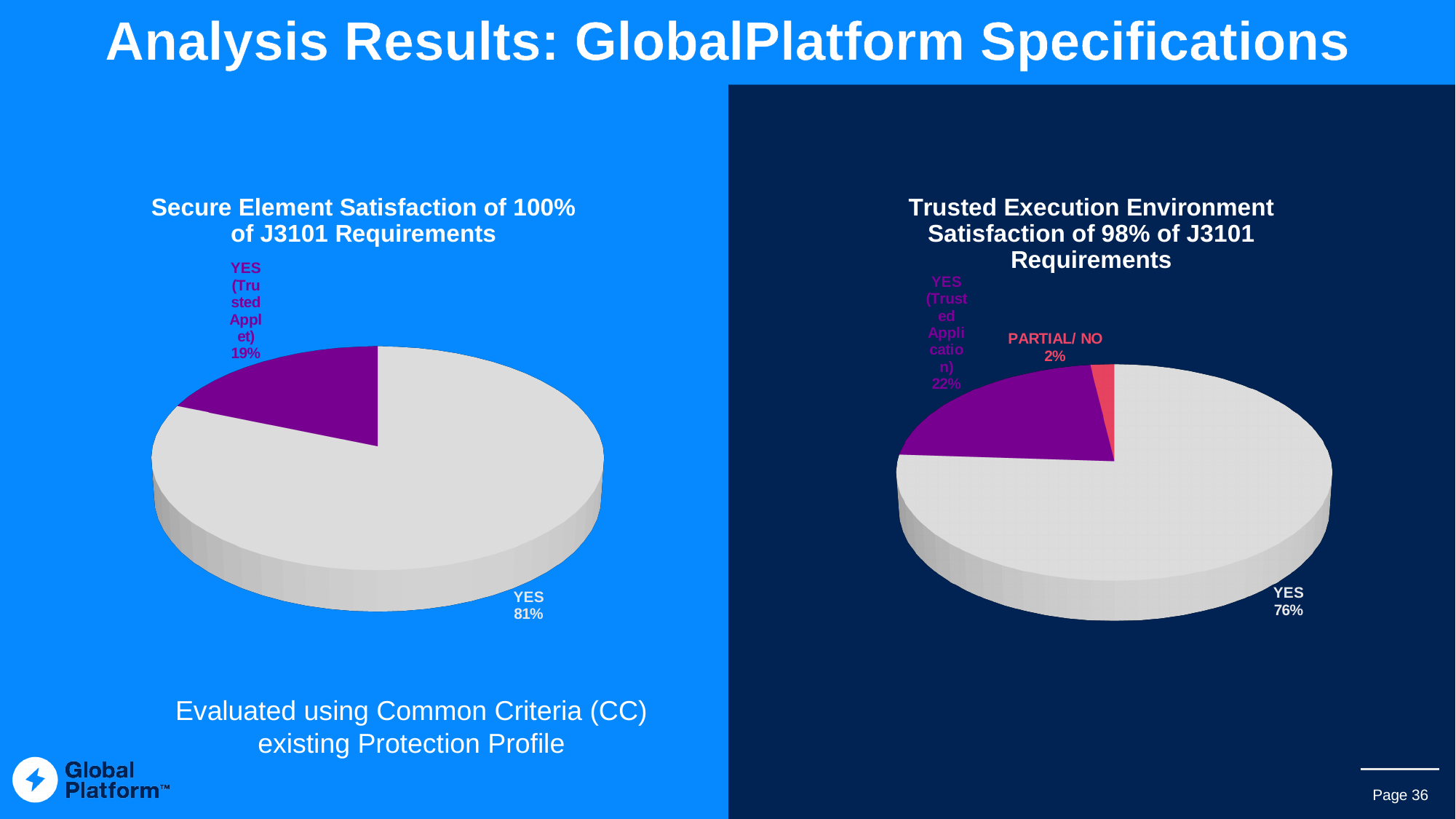
In the 'Trusted Execution Environment Satisfaction of 98% of J3101 Requirements' chart, which slice is the smallest? PARTIAL/ NO In the 'Trusted Execution Environment Satisfaction of 98% of J3101 Requirements' chart, what share does the YES (Trusted Application) slice have? 22% What type of chart is the chart on the left of the slide? Pie chart In the 'Trusted Execution Environment Satisfaction of 98% of J3101 Requirements' chart, what share does the PARTIAL/ NO slice have? 2% In the 'Secure Element Satisfaction of 100% of J3101 Requirements' chart, which slice is the largest? YES In the 'Trusted Execution Environment Satisfaction of 98% of J3101 Requirements' chart, what share does the YES slice have? 76% In the 'Secure Element Satisfaction of 100% of J3101 Requirements' chart, what share does the YES slice have? 81% In the 'Secure Element Satisfaction of 100% of J3101 Requirements' chart, what share does the YES (Trusted Applet) slice have? 19% How many slices does the 'Secure Element Satisfaction of 100% of J3101 Requirements' chart have? 2 In the 'Trusted Execution Environment Satisfaction of 98% of J3101 Requirements' chart, what is the difference between the YES and YES (Trusted Application) shares? 54% How many slices does the 'Trusted Execution Environment Satisfaction of 98% of J3101 Requirements' chart have? 3 In the 'Secure Element Satisfaction of 100% of J3101 Requirements' chart, what is the difference between the YES and YES (Trusted Applet) shares? 62%